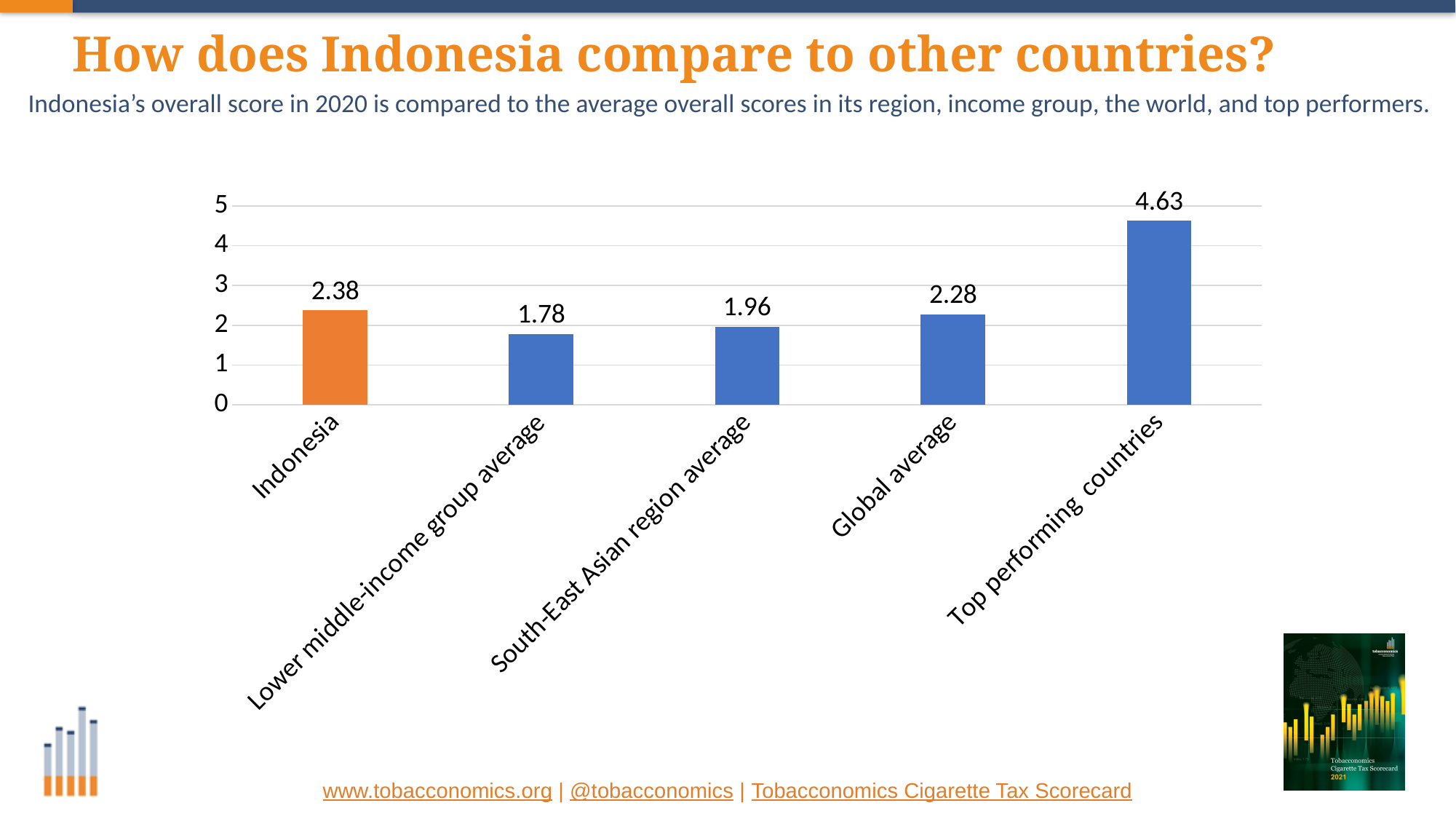
What is the value for the Global average? 2.28 What is the overall score for Indonesia? 2.38 What is the value for the South-East Asian region average? 1.96 Which category has the lowest value? Lower middle-income group average How many categories are shown in the chart? 5 Which category has the highest value? Top performing countries What is the value for Top performing countries? 4.63 What kind of chart is shown on the slide? Bar chart Which bar is coloured orange rather than blue? Indonesia Which is larger, the value for Indonesia or the Global average? Indonesia What is the difference between the value for Top performing countries and the value for Indonesia? 2.25 What is the value for the Lower middle-income group average? 1.78